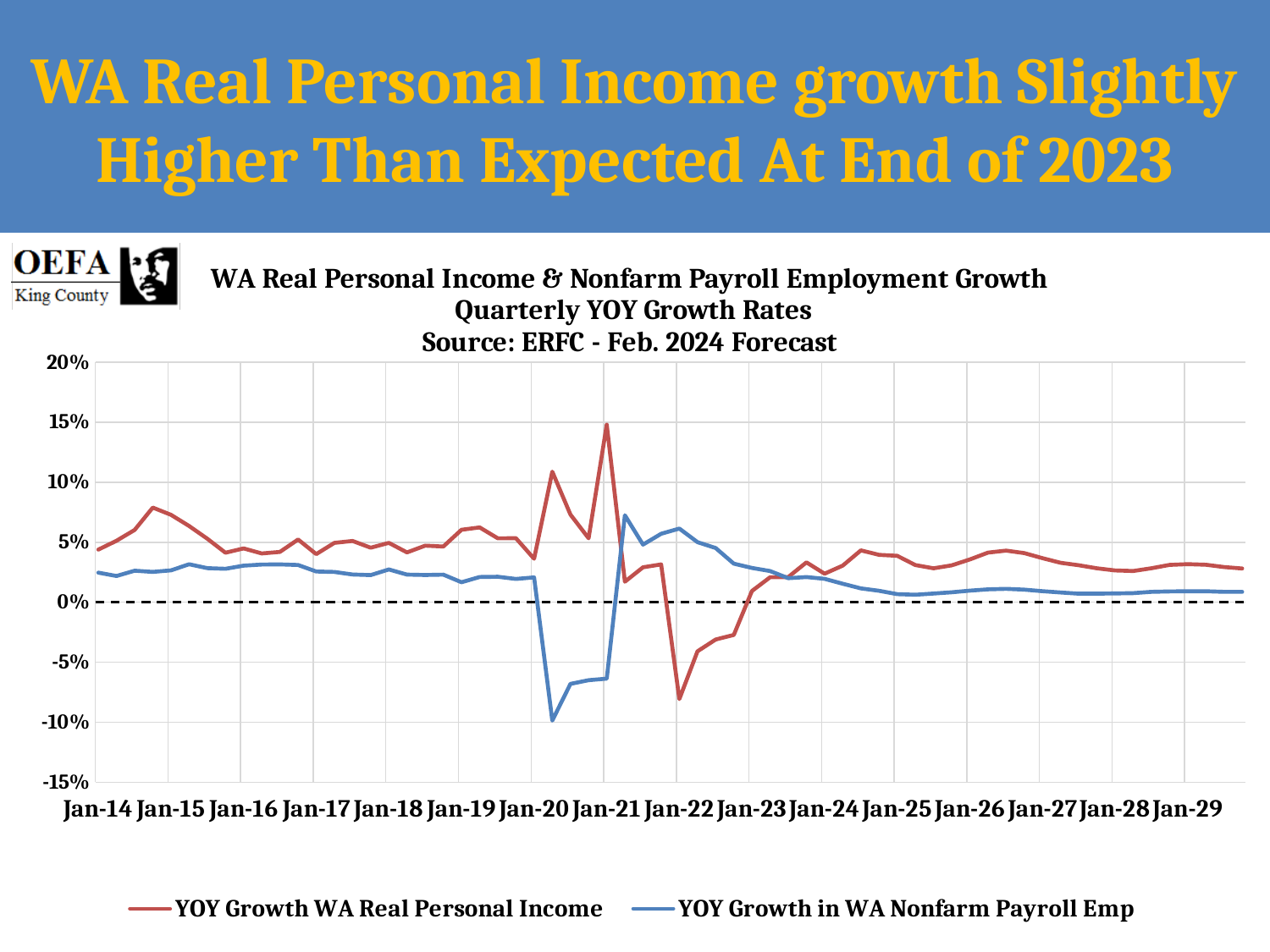
How many series does the legend list? 2 What kind of chart is shown on the slide? line chart Which series reaches the lowest value on the chart? YOY Growth in WA Nonfarm Payroll Emp How many year labels (Jan-14 through Jan-29) are shown on the x axis? 16 At Jan-15, which series has the higher value? YOY Growth WA Real Personal Income What value does the dashed horizontal line mark? 0% Is the value of YOY Growth in WA Nonfarm Payroll Emp at Jan-29 greater or less than 5%? less Is the lowest value of YOY Growth in WA Nonfarm Payroll Emp in 2020 greater or less than -5%? less Which series reaches the highest peak on the chart? YOY Growth WA Real Personal Income Which series is drawn in red? YOY Growth WA Real Personal Income Between Jan-14 and Jan-15, does the YOY Growth WA Real Personal Income line rise or fall? rise Is the peak value of YOY Growth WA Real Personal Income around Jan-21 greater or less than 10%? greater